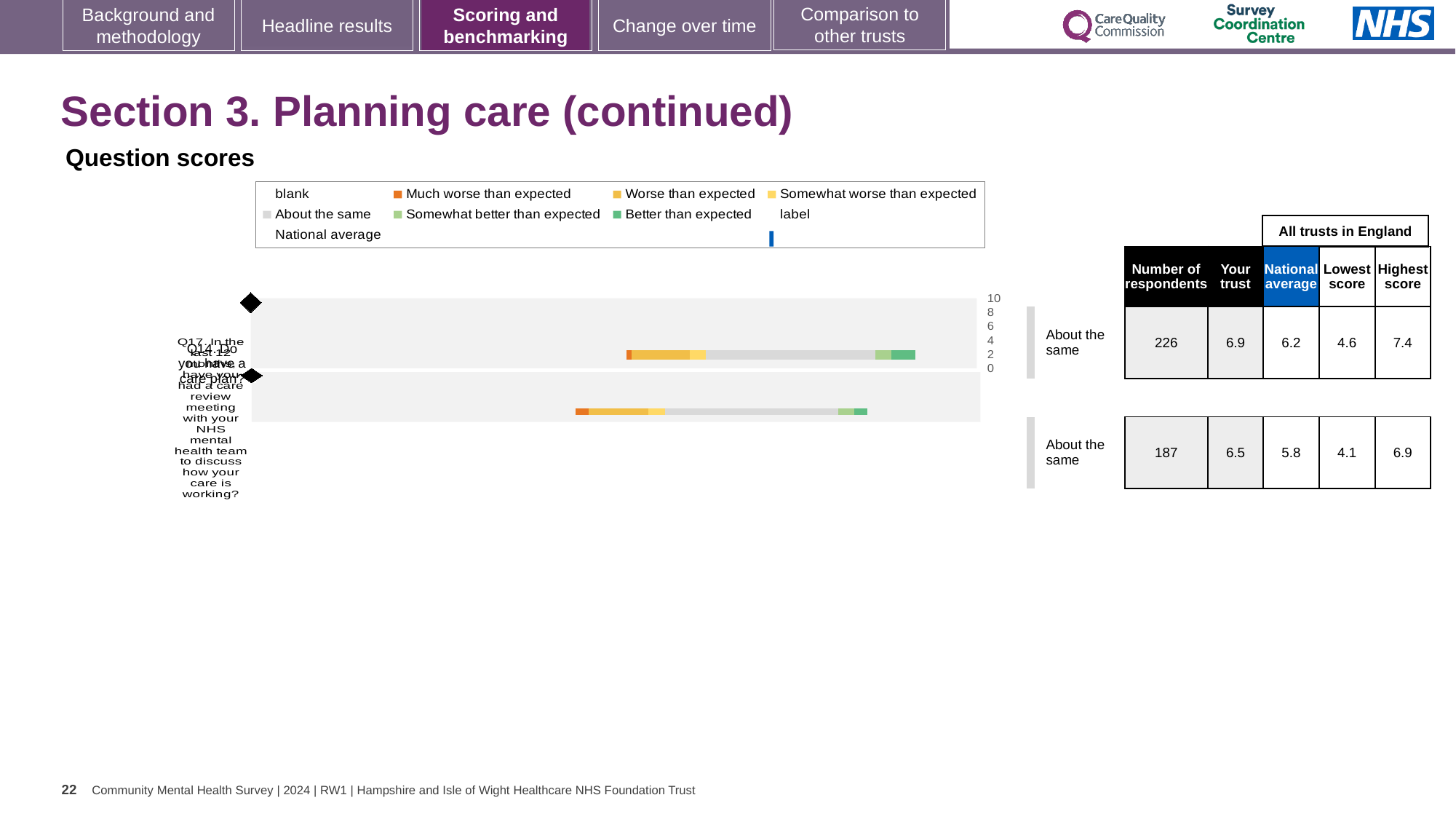
Which question has the higher 'Your trust' score, Q14 or Q17? Q14 What is the difference between the 'Your trust' score and the national average for Q14? 0.7 In the chart legend, which colour represents 'Much worse than expected'? orange In the table next to the chart, what is the national average score for Q17 (care review meeting in the last 12 months)? 5.8 In the table next to the chart, what is the highest score among all trusts in England for Q17? 6.9 In the table next to the chart, what is the number of respondents for Q14 (Do you have a care plan?)? 226 What is the difference in the number of respondents between Q14 and Q17? 39 In the table next to the chart, what is the 'Your trust' score for Q14 (Do you have a care plan?)? 6.9 What benchmark category is shown for Q17 beside the chart? About the same In the table next to the chart, what is the lowest score among all trusts in England for Q14? 4.6 What kind of chart is used to show the question scores on this slide? bar chart How many questions (bars) are plotted in the question scores chart? 2